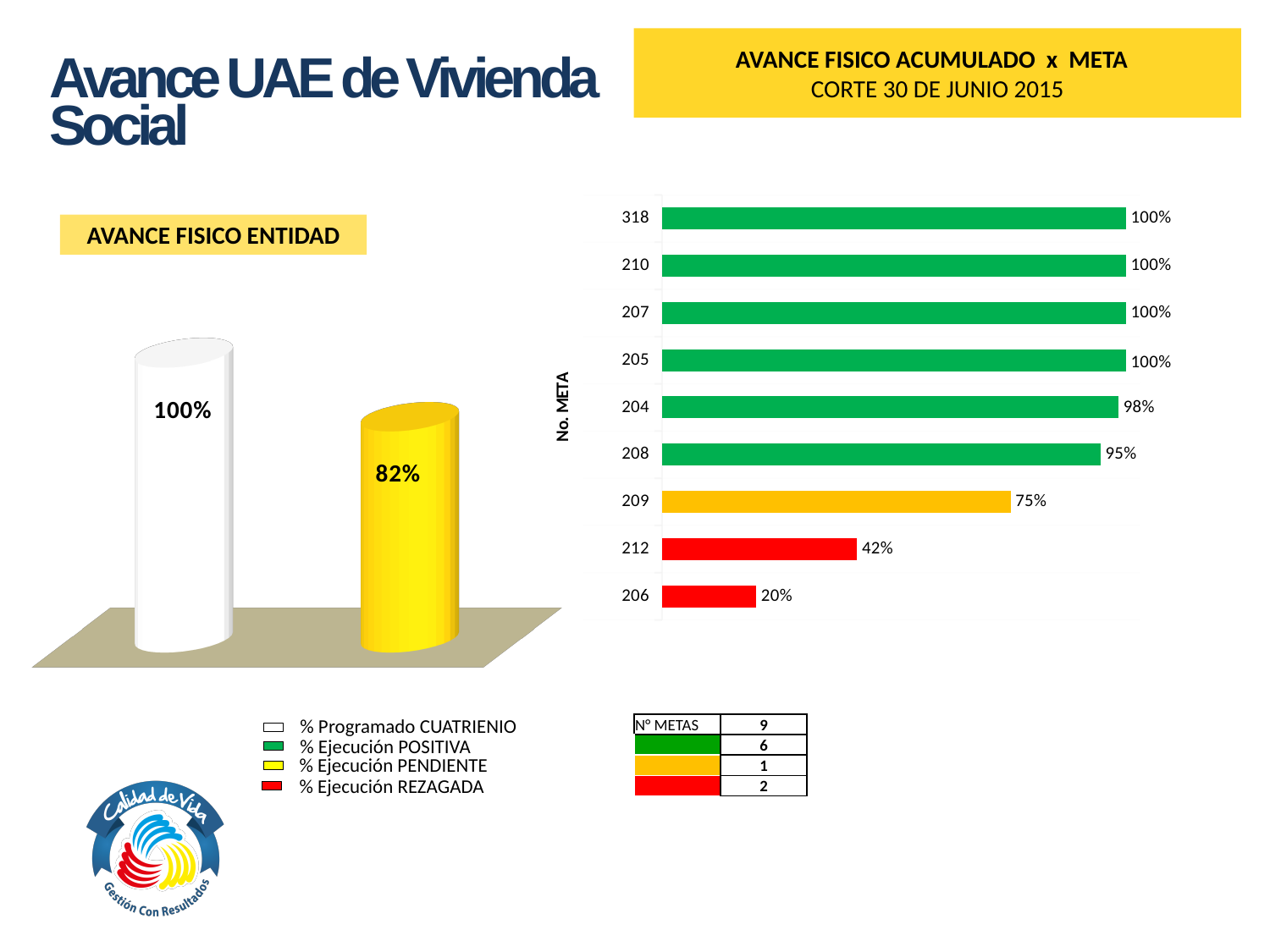
In the AVANCE FISICO ACUMULADO x META chart, which meta has the lowest value? 206 In the AVANCE FISICO ENTIDAD chart, what is the difference between the % Programado CUATRIENIO bar and the % Ejecución PENDIENTE bar? 18% In the AVANCE FISICO ACUMULADO x META chart, what is the value for meta 212? 42% In the AVANCE FISICO ENTIDAD chart, what is the value of the yellow bar (% Ejecución PENDIENTE)? 82% What kind of chart is the AVANCE FISICO ACUMULADO x META chart? bar chart In the AVANCE FISICO ACUMULADO x META chart, how many metas have a value of 100%? 4 In the AVANCE FISICO ACUMULADO x META chart, what colour is the bar for meta 209? yellow In the AVANCE FISICO ACUMULADO x META chart, which is larger, the value for meta 209 or the value for meta 212? 209 How many metas are shown in the AVANCE FISICO ACUMULADO x META chart? 9 In the AVANCE FISICO ACUMULADO x META chart, what is the value for meta 204? 98% In the AVANCE FISICO ACUMULADO x META chart, what is the value for meta 209? 75% In the AVANCE FISICO ACUMULADO x META chart, what is the difference between the values for meta 208 and meta 206? 75%